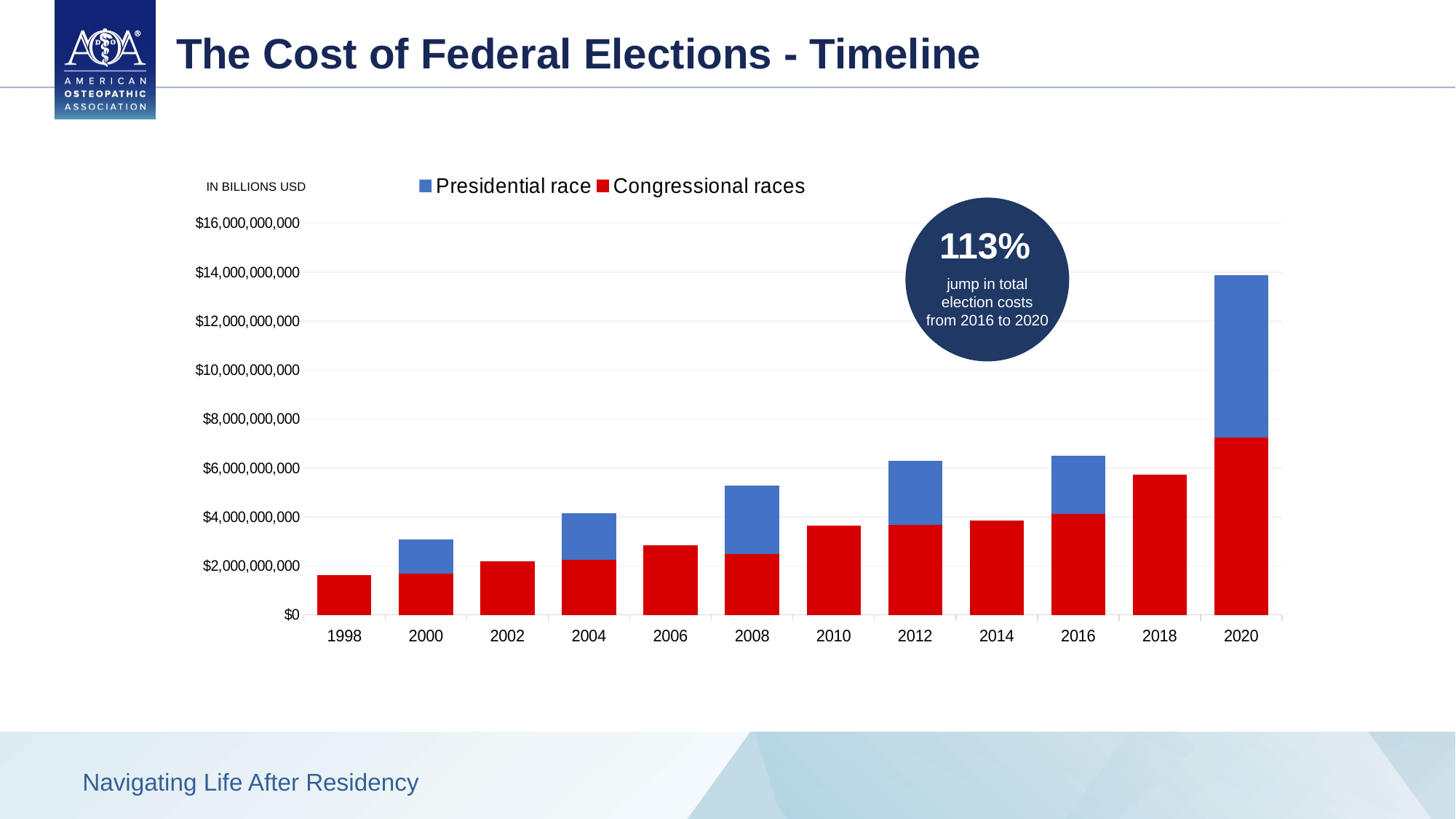
Which year has a larger total election cost, 2016 or 2020? 2020 Which year has the highest total election cost? 2020 How many election years are shown on the x axis? 12 What kind of chart is shown on the slide? bar chart How many series does the legend list? 2 Do total election costs generally rise or fall from 1998 to 2020? rise Which year has the lowest total election cost? 1998 Is the total election cost for 2016 greater or less than $6,000,000,000? greater Which series is shown in red? Congressional races Is the total election cost for 1998 greater or less than $2,000,000,000? less Is the total election cost for 2020 greater or less than $12,000,000,000? greater